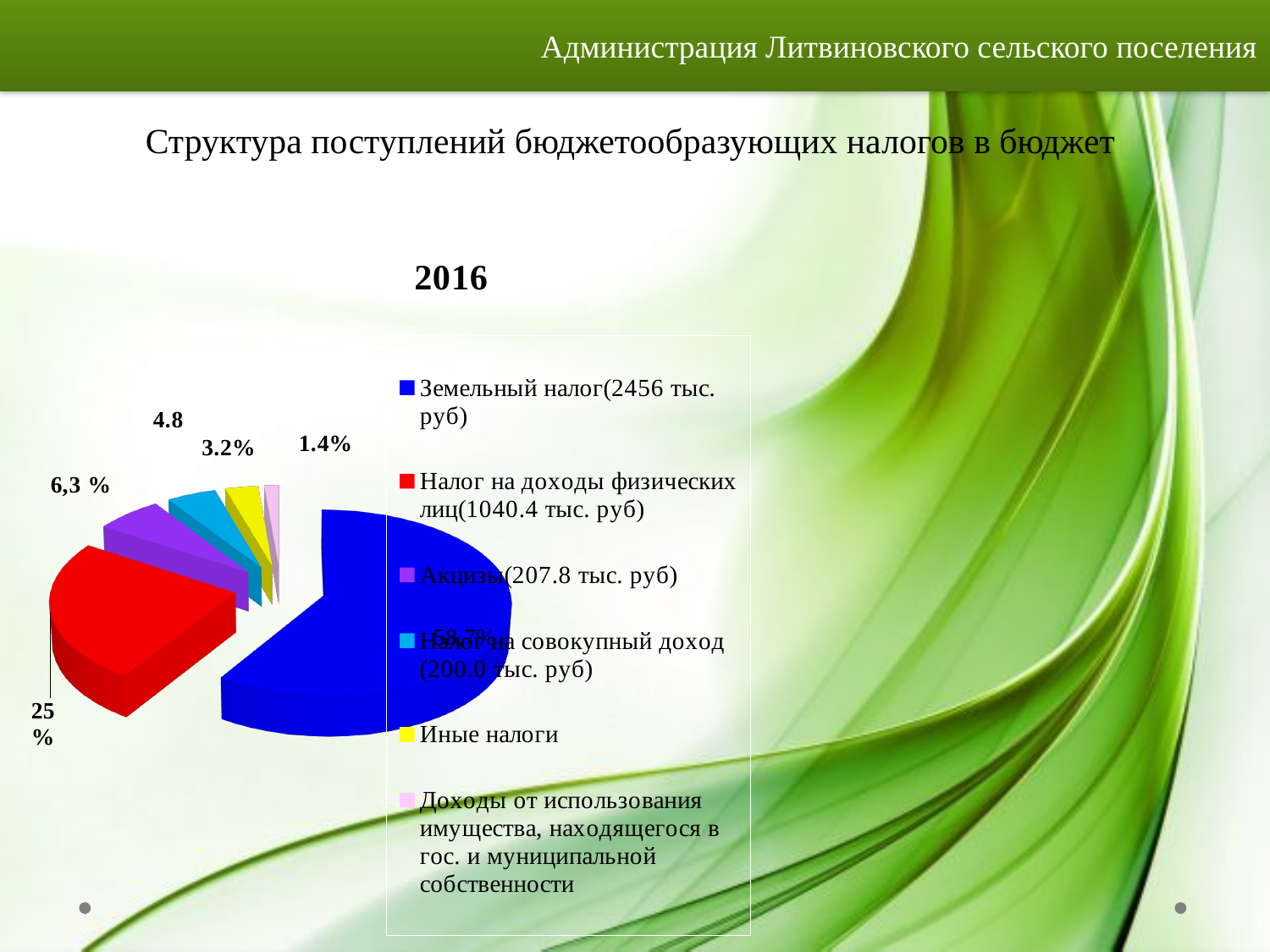
What is the difference between the share for Иные налоги and the share for Доходы от использования имущества? 1.8% What share of the pie is labelled for Доходы от использования имущества, находящегося в гос. и муниципальной собственности? 1.4% What share of the pie is labelled for Налог на доходы физических лиц? 25 % What kind of chart is shown on the slide? pie chart What value is labelled for Налог на совокупный доход? 4.8 Which is larger: the share for Налог на доходы физических лиц or the share for Акцизы? Налог на доходы физических лиц What share of the pie is labelled for Иные налоги? 3.2% Which category has the largest share of the pie? Земельный налог(2456 тыс. руб) How many slices does the pie chart have? 6 What is the title of the pie chart? 2016 Which category has the smallest share of the pie? Доходы от использования имущества, находящегося в гос. и муниципальной собственности